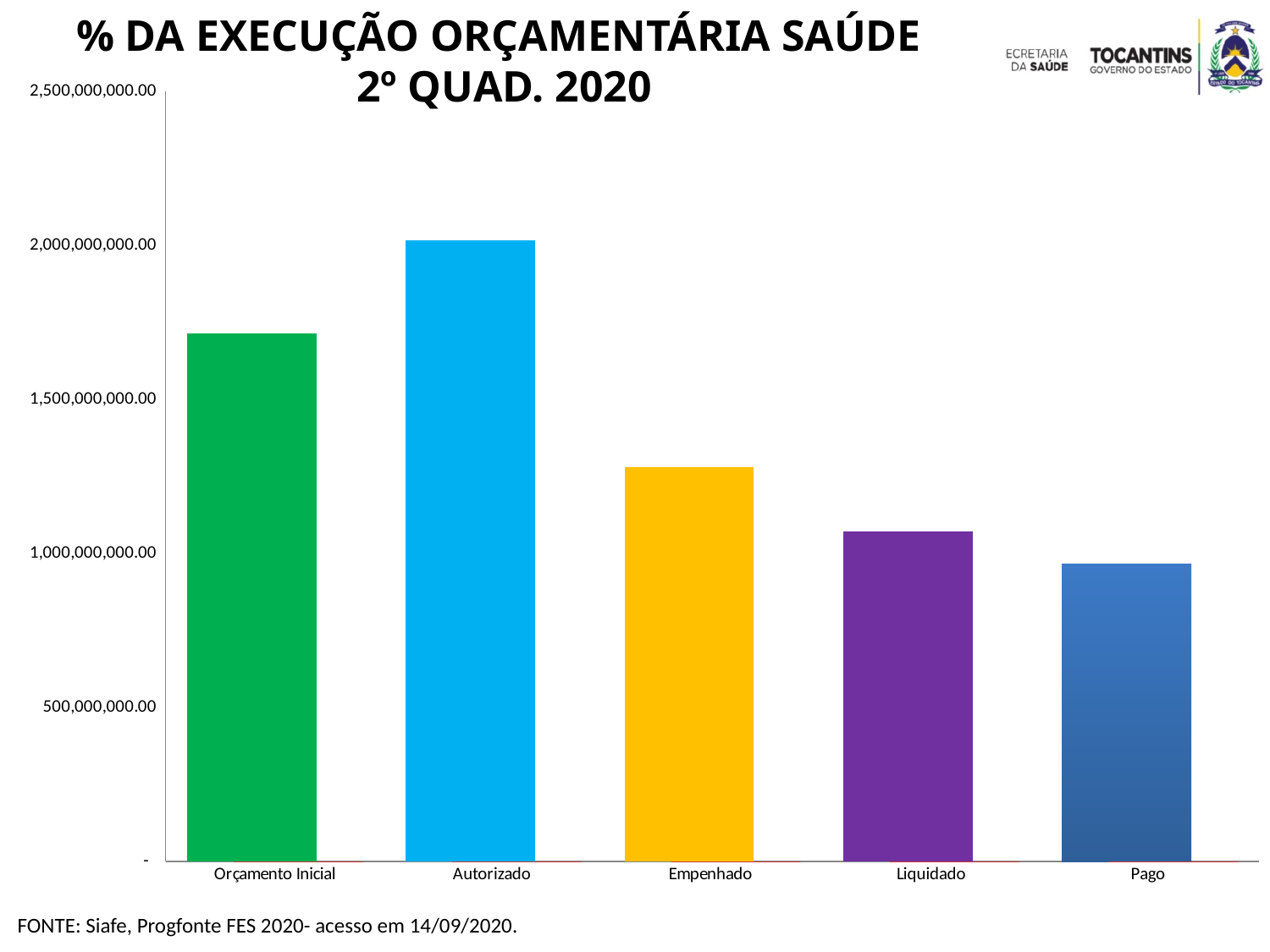
Is the value for Empenhado greater or less than 1,500,000,000.00? less From Autorizado to Pago, do the bar values rise or fall along the x axis? fall Which category has the highest value in the chart? Autorizado How many categories are shown on the x axis of the chart? 5 Is the value for Pago greater or less than 500,000,000.00? greater Which category has the lowest value in the chart? Pago Which is larger, the value for Liquidado or the value for Autorizado? Autorizado Is the value for Orçamento Inicial greater or less than 1,500,000,000.00? greater What kind of chart is shown on the slide? bar chart Which is larger, the value for Orçamento Inicial or the value for Empenhado? Orçamento Inicial What is the title of the chart? % DA EXECUÇÃO ORÇAMENTÁRIA SAÚDE 2º QUAD. 2020